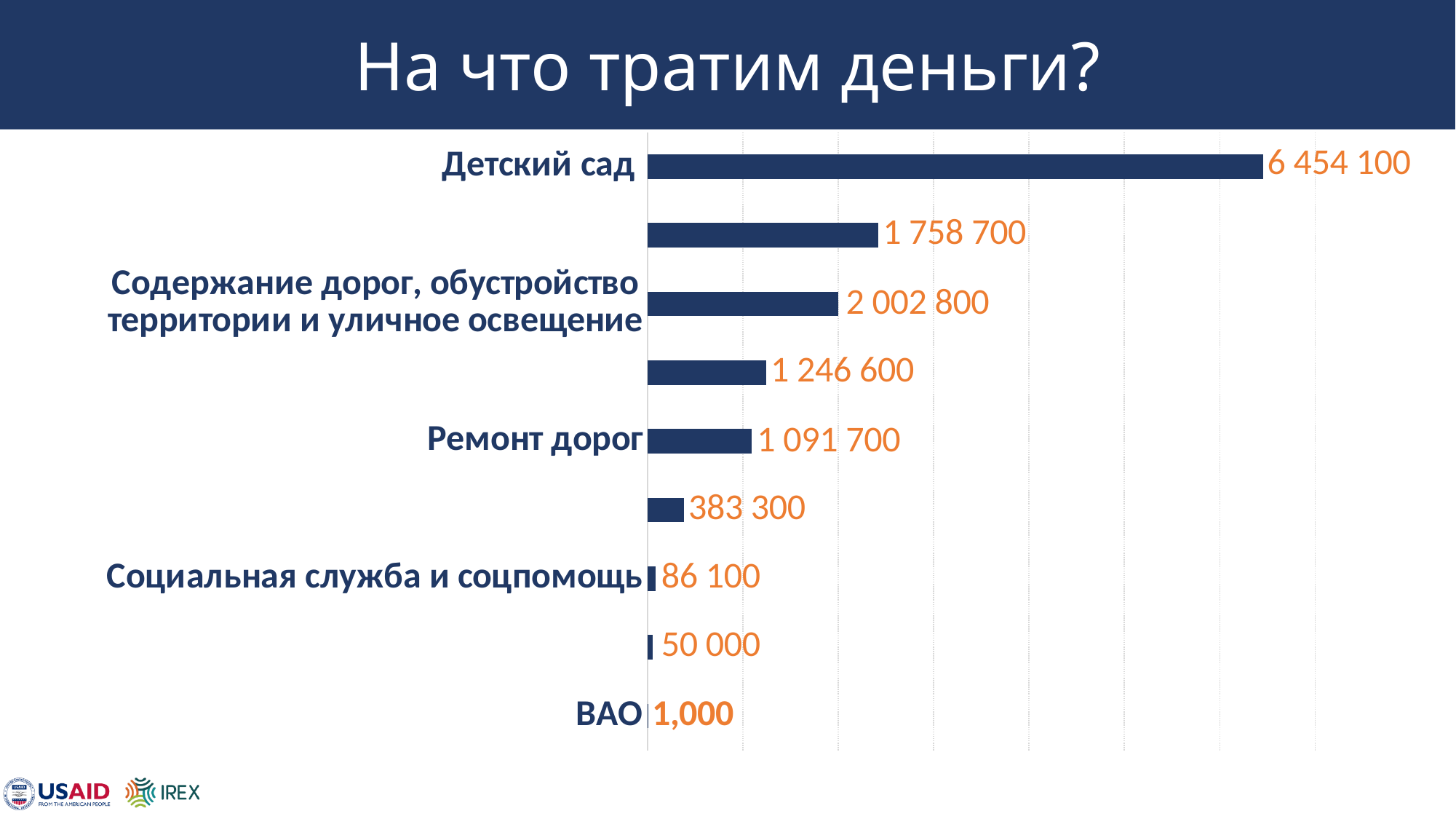
What is the value for Содержание дорог, обустройство территории и уличное освещение? 2 002 800 What is the value for Детский сад? 6 454 100 What is the difference between the value for Детский сад and the value for Ремонт дорог? 5 362 400 What is the value for ВАО? 1,000 Which category has the lowest value? ВАО Which is larger: the value for Содержание дорог, обустройство территории и уличное освещение or the value for Ремонт дорог? Содержание дорог, обустройство территории и уличное освещение What is the value for Ремонт дорог? 1 091 700 Which category has the highest value? Детский сад How many bars are plotted in the chart? 9 What kind of chart is shown on the slide? bar chart What is the value for Социальная служба и соцпомощь? 86 100 What is the title of the chart on the slide? На что тратим деньги?